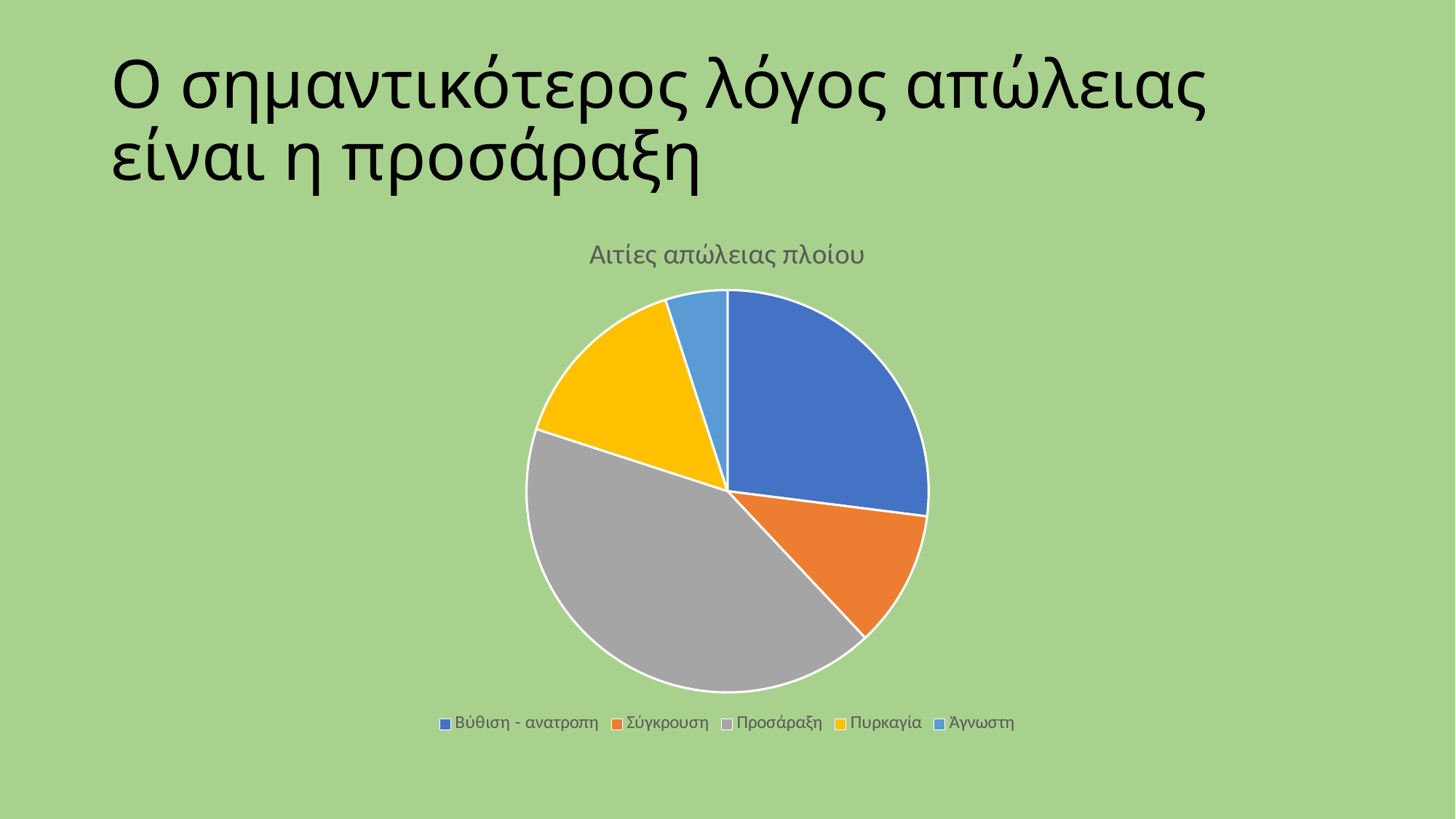
Which category has the largest slice of the pie? Προσάραξη What kind of chart is shown on the slide? Pie chart Which slice is larger, Βύθιση - ανατροπη or Σύγκρουση? Βύθιση - ανατροπη Which slice is larger, Πυρκαγία or Άγνωστη? Πυρκαγία Which slice is larger, Σύγκρουση or Άγνωστη? Σύγκρουση Which category has the smallest slice of the pie? Άγνωστη How many slices does the pie chart have? 5 What is the title of the chart? Αιτίες απώλειας πλοίου What colour is the slice for Προσάραξη? Grey How many entries does the chart legend list? 5